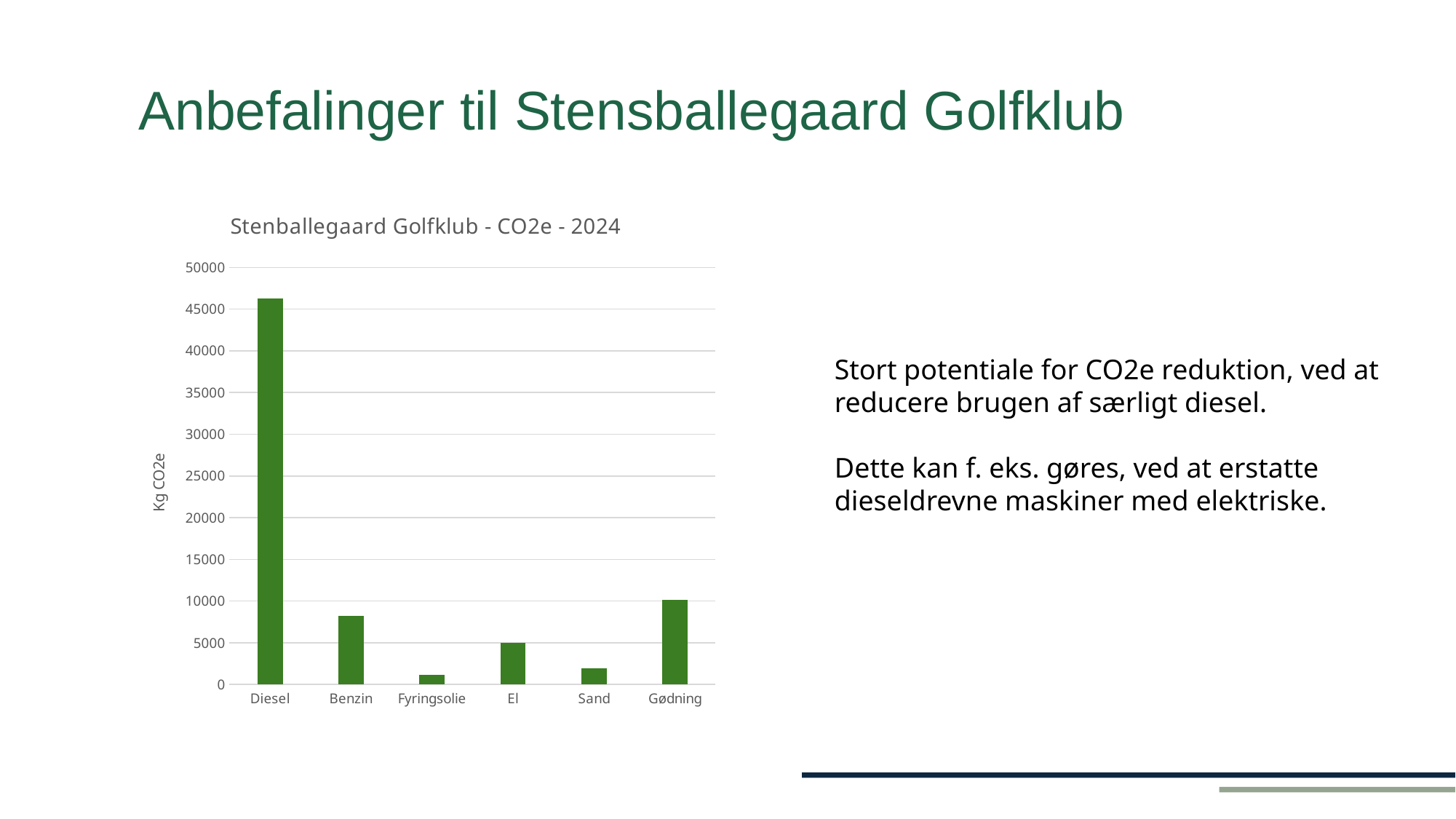
Is the value for Sand greater or less than 5000? less Which category has the highest CO2e value? Diesel What is the title of the chart? Stenballegaard Golfklub - CO2e - 2024 What kind of chart is shown on the slide? bar chart Is the value for Benzin greater or less than 10000? less Which category has the lowest CO2e value? Fyringsolie What is the label on the vertical axis of the chart? Kg CO2e Is the value for Fyringsolie greater or less than 5000? less Which is larger, the value for Gødning or the value for Benzin? Gødning Which is larger, the value for El or the value for Sand? El How many categories are shown on the x axis of the chart? 6